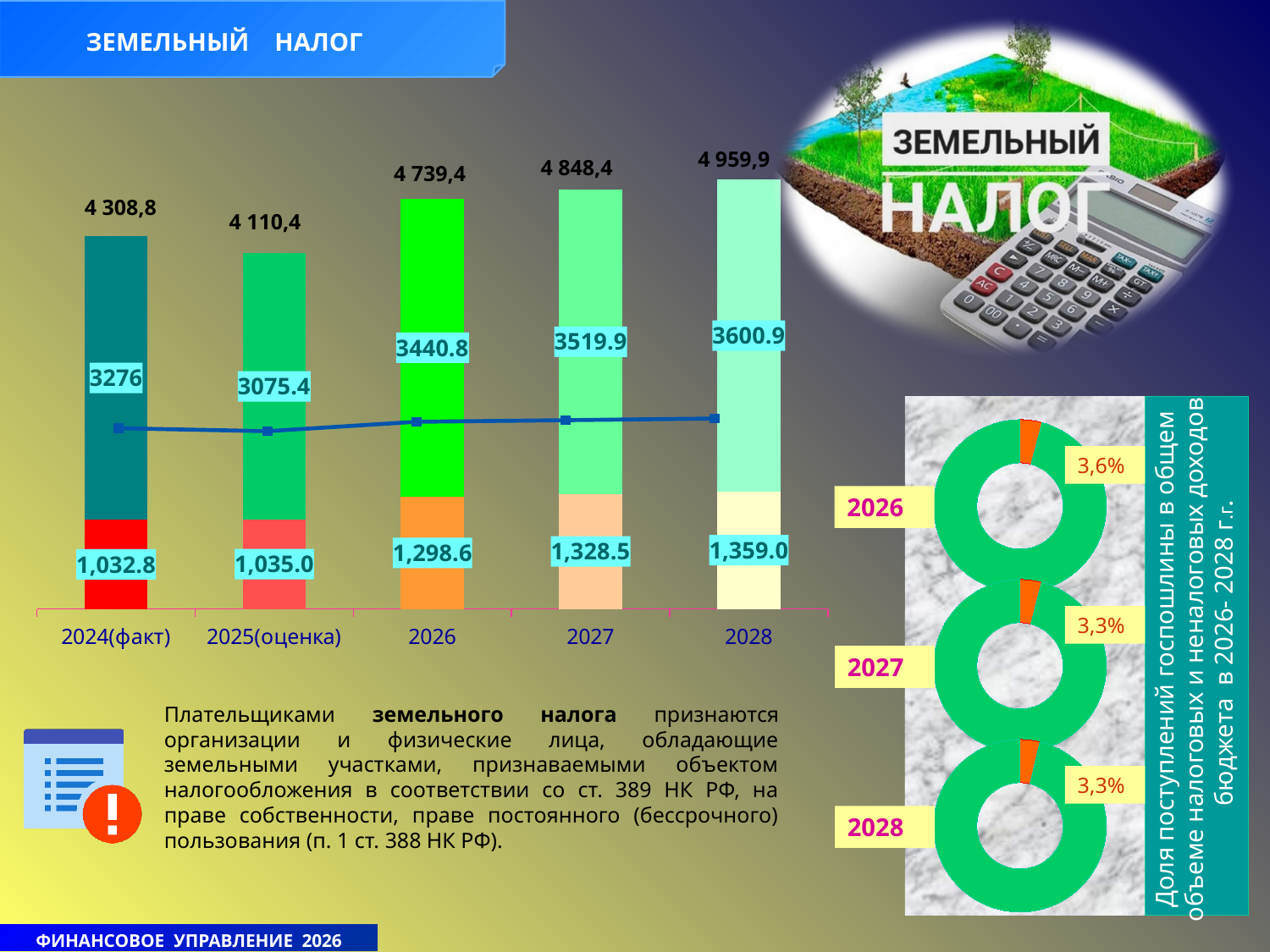
In the bar chart on the left, what is the difference between the total values above the bars for 2028 and 2027? 111,5 In the bar chart on the left, what is the difference between the upper segment values for 2027 and 2026? 79.1 In the bar chart on the left, which is larger: the bottom segment for 2027 or for 2026? 2027 In the bar chart on the left, what is the value of the upper segment of the 2028 bar? 3600.9 What kind of chart is the chart on the left of the slide? bar chart In the bar chart on the left, what is the value of the bottom segment of the 2024(факт) bar? 1,032.8 In the bar chart on the left, which category has the lowest total value above its bar? 2025(оценка) In the bar chart on the left, which year has the highest total value above its bar? 2028 How many categories are shown on the x axis of the bar chart on the left? 5 In the bar chart on the left, do the total values above the bars rise or fall from 2025(оценка) to 2028? rise In the bar chart on the left, what is the total value shown above the bar for 2026? 4 739,4 In the donut charts on the right, what share is shown for 2026? 3,6%